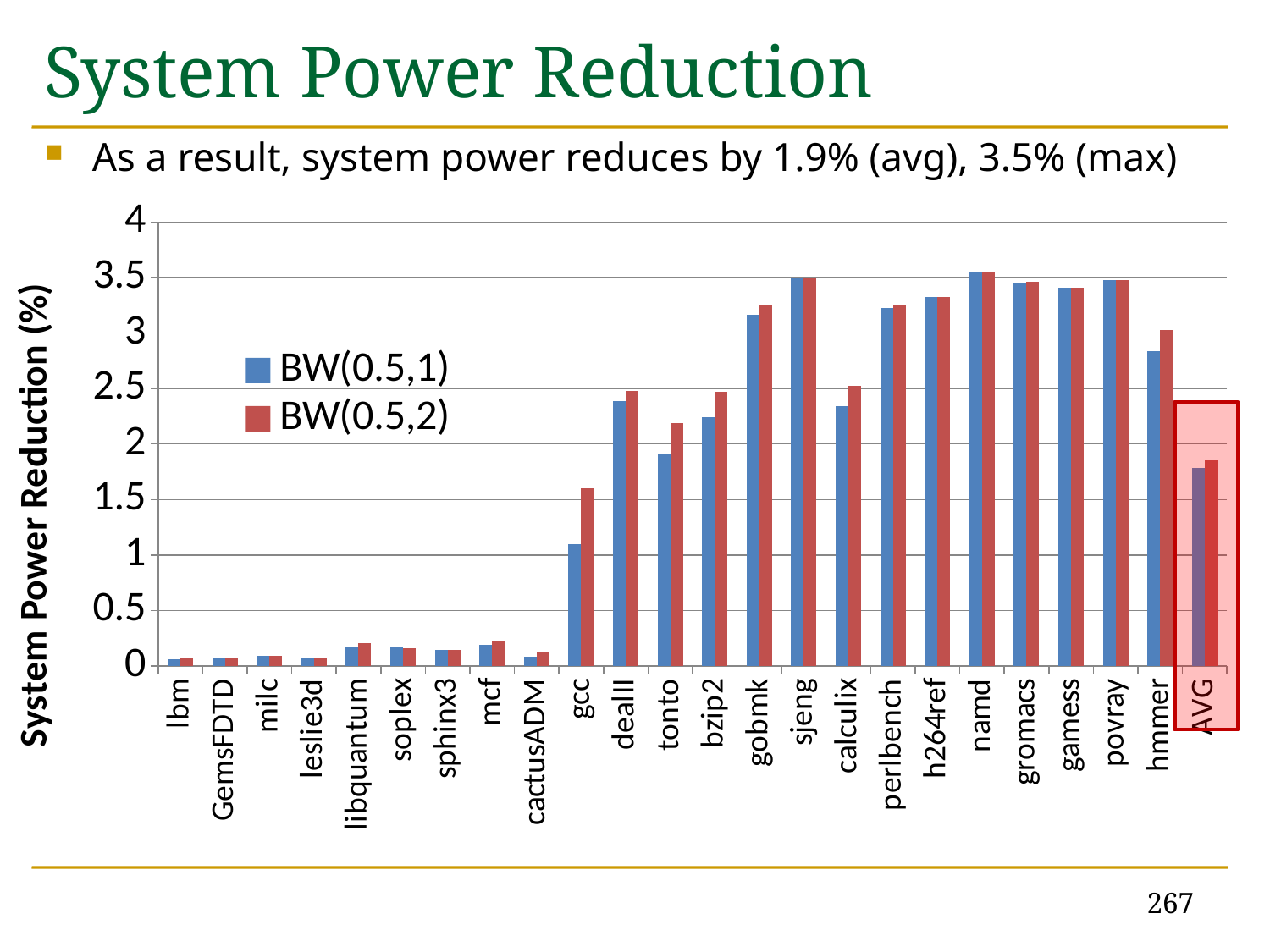
How many categories are shown along the x axis? 24 Is the BW(0.5,1) value for hmmer greater or less than 3? less Which category has the larger BW(0.5,1) value, gcc or dealII? dealII Is the BW(0.5,2) value for AVG greater or less than 1.5? greater What is the label of the y axis? System Power Reduction (%) Which series is larger for gcc, BW(0.5,1) or BW(0.5,2)? BW(0.5,2) Is the BW(0.5,1) value for gobmk greater or less than 3? greater Which series is larger for tonto, BW(0.5,1) or BW(0.5,2)? BW(0.5,2) What kind of chart is shown on the slide? bar chart How many series does the legend list? 2